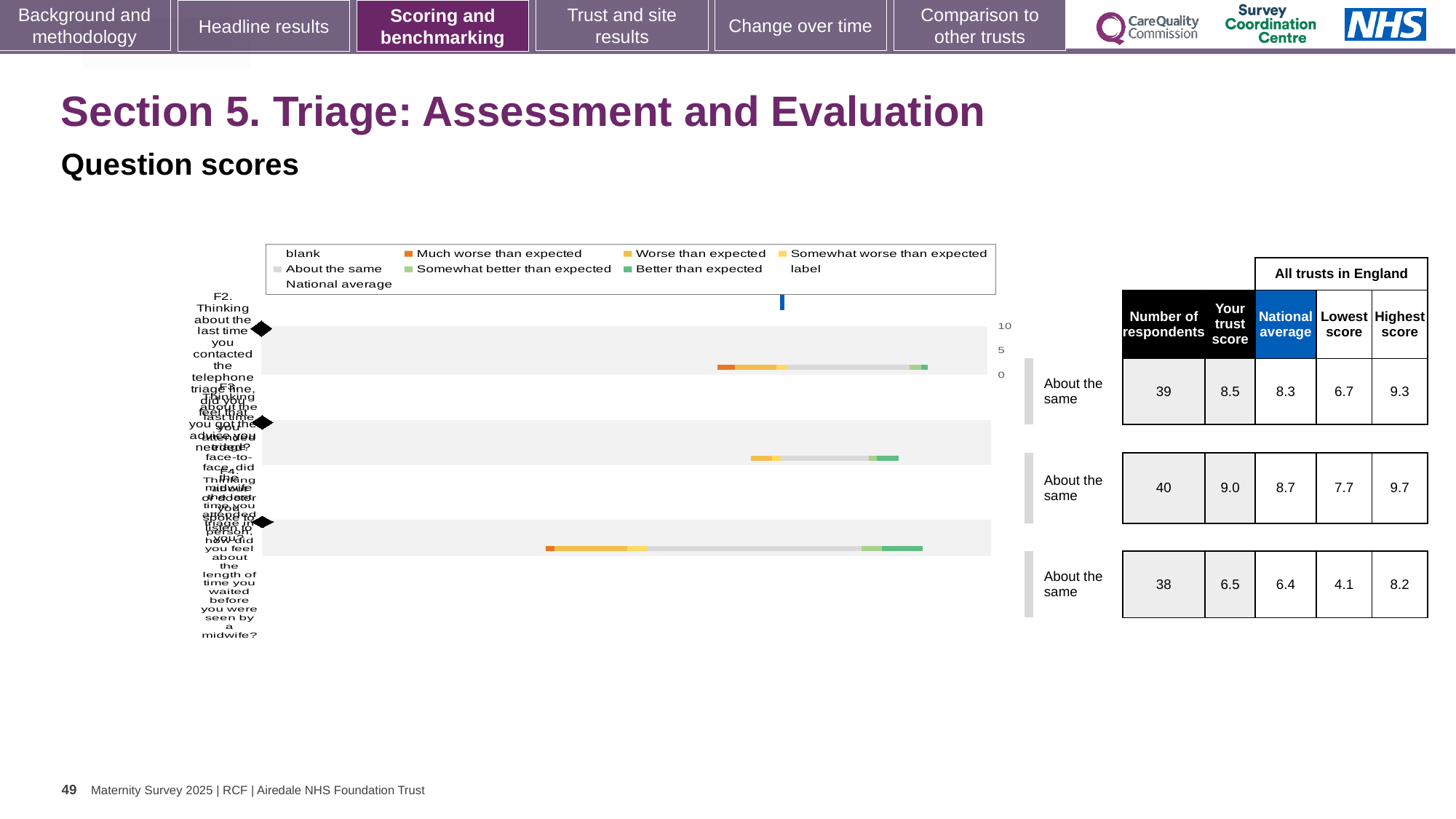
What benchmark category is shown for all three questions? About the same What is the lowest score among all trusts in England for the third question (F4)? 4.1 What is the highest score among all trusts in England for the second question (F3)? 9.7 How many questions (rows) are plotted in the chart? 3 What is the national average for the second question (F3)? 8.7 What is the 'Your trust score' for the top question (F2) in the table beside the chart? 8.5 What is the difference between the highest score and the lowest score for the third question (F4)? 4.1 Which question has the lowest 'Your trust score'? the third question (F4), 6.5 What kind of chart is shown on the slide? bar chart Which question has the highest 'Your trust score'? the second question (F3), 9.0 For the top question (F2), which is larger: the trust score or the national average? the trust score (8.5) What is the number of respondents for the top question (F2)? 39